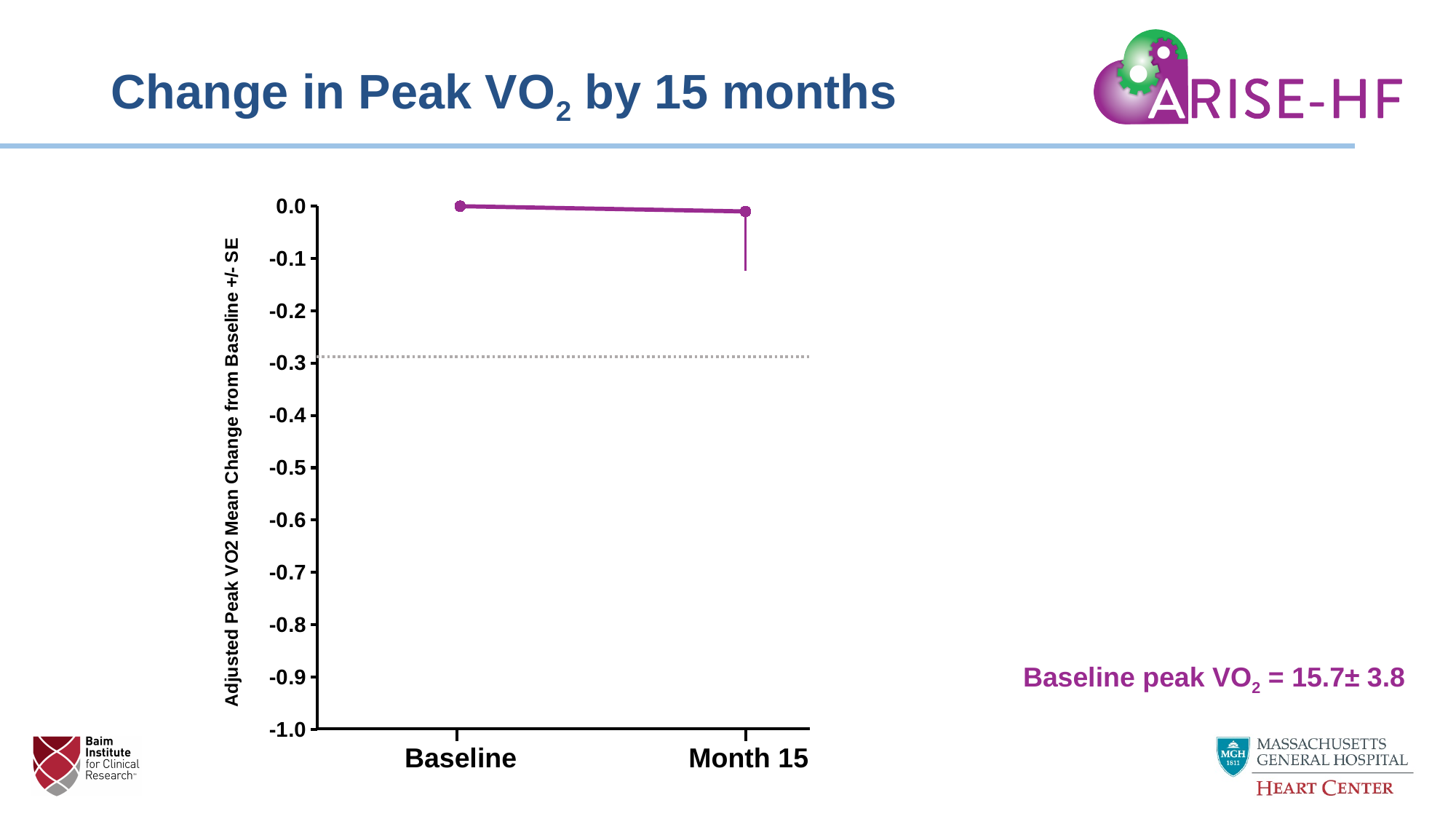
What kind of chart is shown on the slide? Line chart Is the value at Month 15 greater or less than -0.3? greater Is the value at Month 15 greater or less than -0.1? greater What are the two categories on the x axis? Baseline and Month 15 What is the lowest value shown on the y axis? -1.0 Does the plotted line rise or fall from Baseline to Month 15? Falls What is the plotted value at Baseline? 0.0 What is the label of the y axis? Adjusted Peak VO2 Mean Change from Baseline +/- SE How many time points are plotted on the x axis? 2 What is the highest value shown on the y axis? 0.0